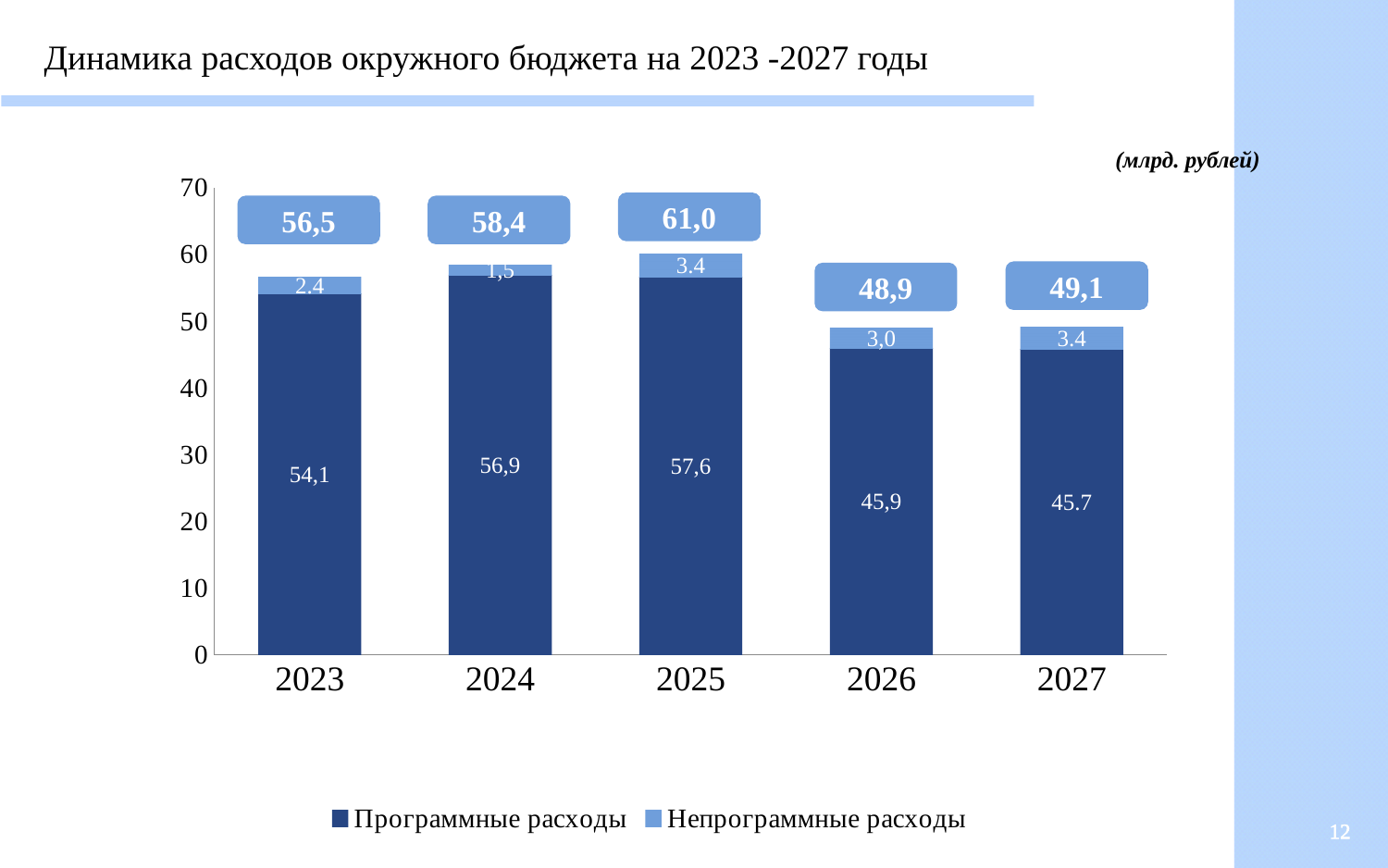
How many series does the legend list? 2 What type of chart is shown on the slide? Stacked bar chart What is the value of Непрограммные расходы for 2026? 3,0 Which year has the highest total expenditure? 2025 How many years are shown on the x axis of the chart? 5 Which is larger: Программные расходы in 2023 or in 2027? 2023 Do the totals rise or fall from 2023 to 2025? Rise What is the difference between the totals for 2025 and 2026? 12,1 What is the value of Программные расходы for 2024? 56,9 What is the total shown above the bar for 2025? 61,0 Which year has the lowest total expenditure? 2026 What unit is stated for the values in the chart? млрд. рублей